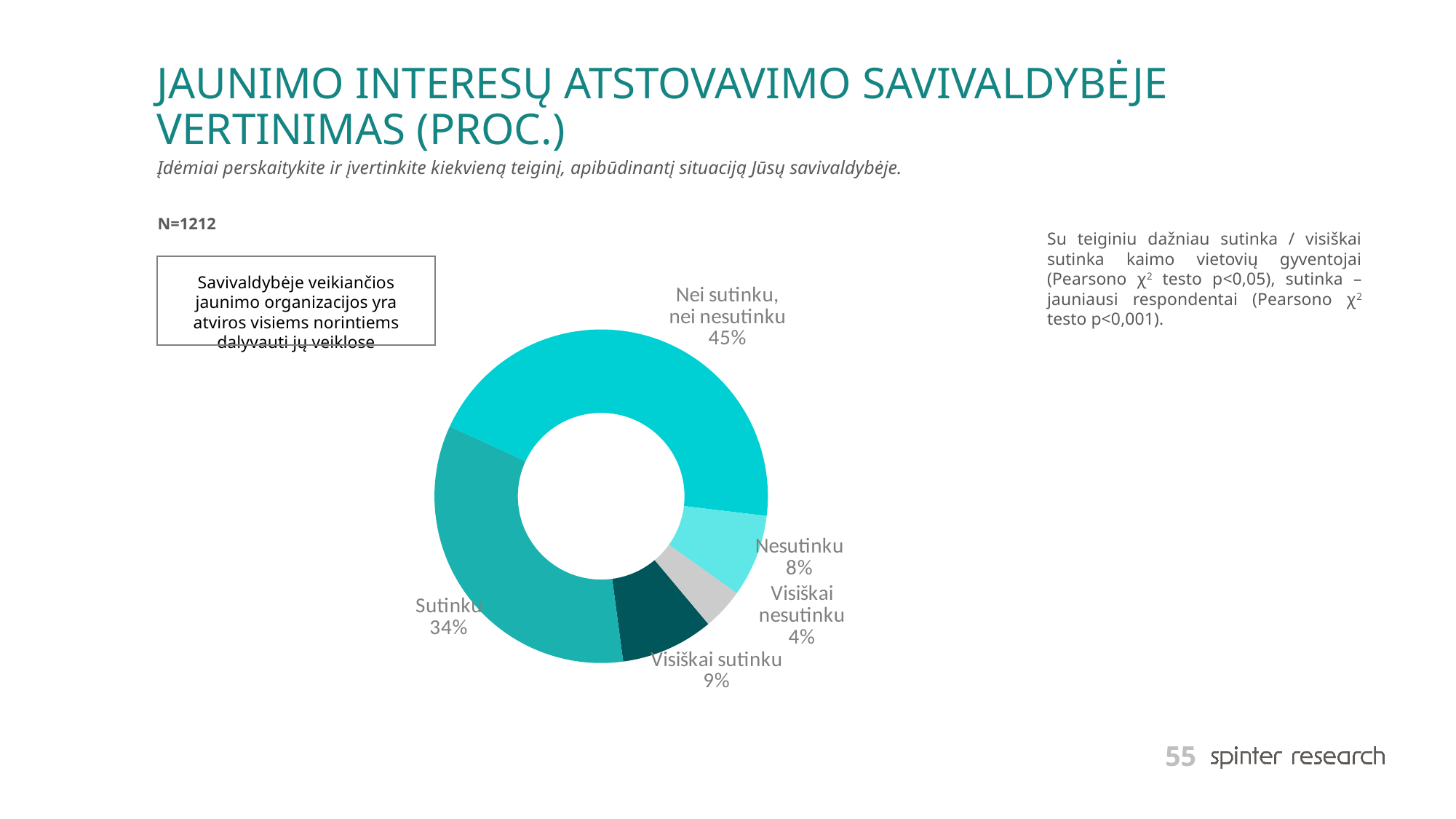
Which response category has the largest share? Nei sutinku, nei nesutinku What is the difference in percentage points between "Nei sutinku, nei nesutinku" and "Sutinku"? 11 Which response category has the smallest share? Visiškai nesutinku What share of respondents answered "Visiškai sutinku"? 9% What is the sample size (N) stated on the slide? N=1212 What share of respondents answered "Sutinku"? 34% What kind of chart is shown on the slide? Pie chart (donut) What share of respondents answered "Visiškai nesutinku"? 4% What share of respondents answered "Nei sutinku, nei nesutinku"? 45% How many response categories are shown in the chart? 5 Which is larger, the share for "Visiškai sutinku" or the share for "Nesutinku"? Visiškai sutinku What share of respondents answered "Nesutinku"? 8%